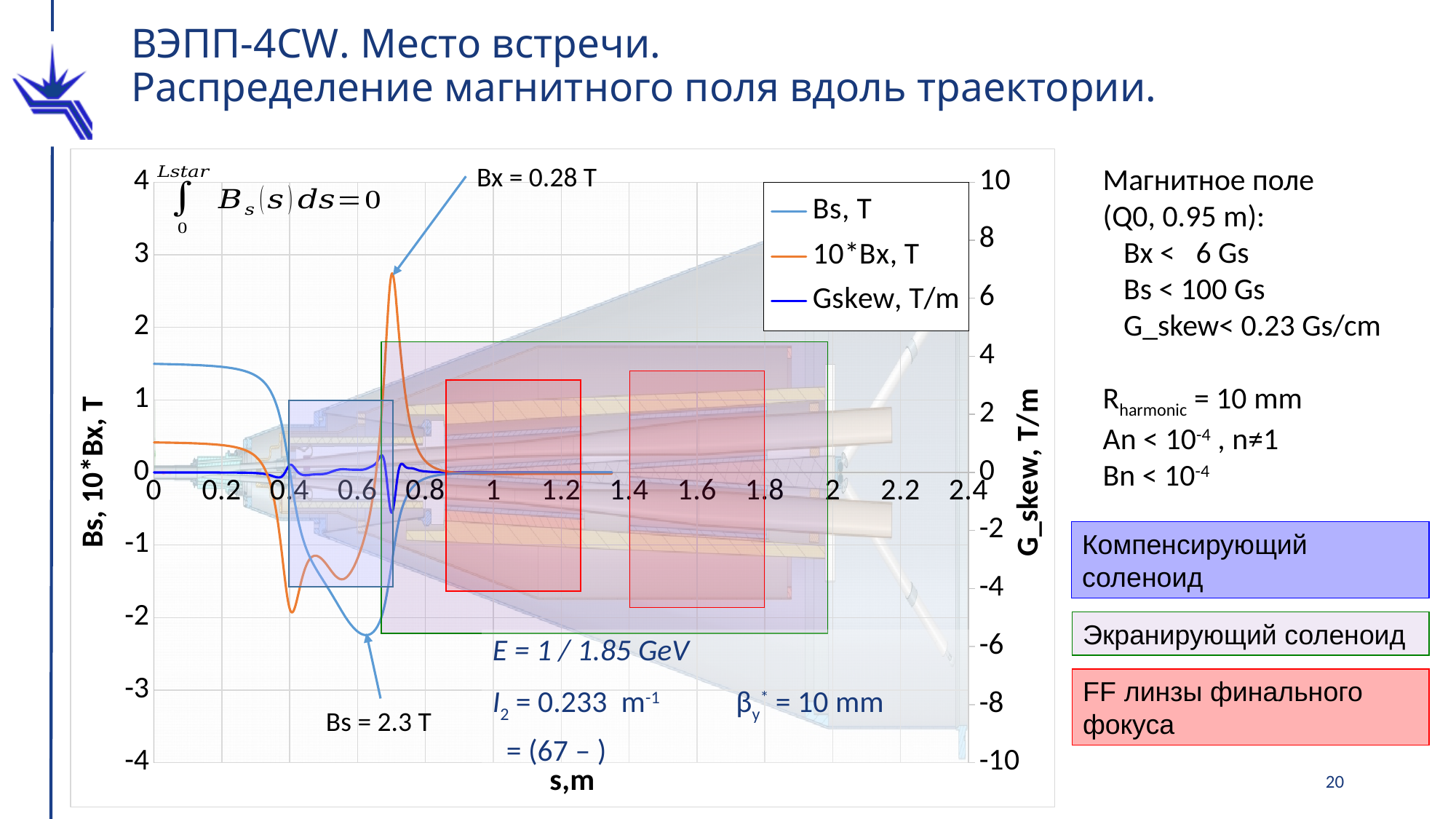
What kind of chart is shown on the slide? line chart What value of Bs is annotated at the dip of the Bs curve near s = 0.7 m? Bs = 2.3 T Does the Bs, T series rise or fall as s goes from 0 to 0.7 m? fall What is the label of the x axis of the chart? s,m What peak value of Bx is annotated on the chart? Bx = 0.28 T Which series reaches the highest value on the left axis, Bs, T or 10*Bx, T? 10*Bx, T What is the range of the right-hand G_skew, T/m axis? -10 to 10 Is the value of the 10*Bx, T series at s = 0 greater or less than 1? less What are the three series named in the chart legend? Bs, T; 10*Bx, T; Gskew, T/m How many series does the chart legend list? 3 Is the value of the Bs, T series at s = 0 greater or less than 2? less Is the value of the Bs, T series at s = 0 greater or less than 1? greater